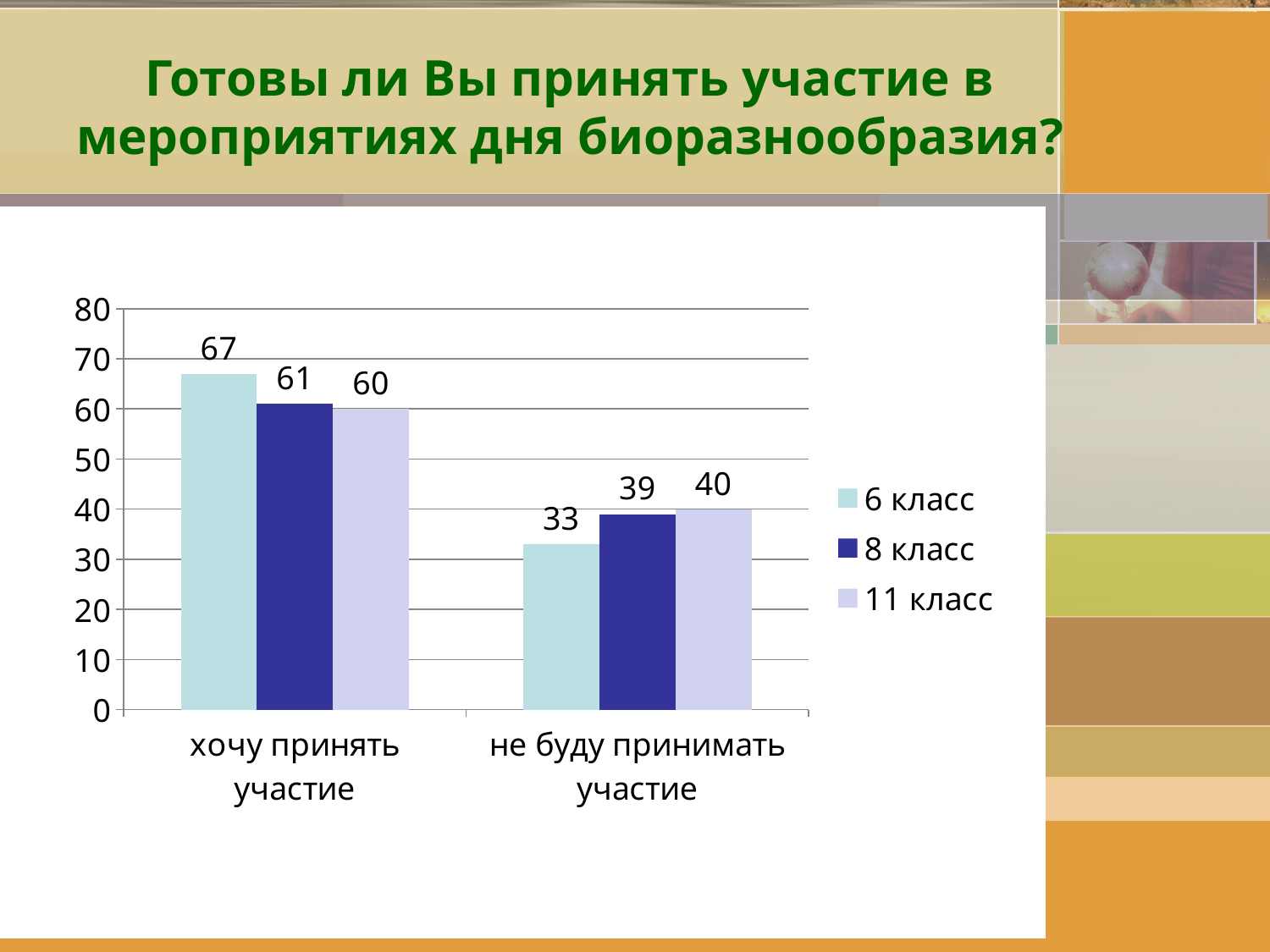
What is the title of the slide? Готовы ли Вы принять участие в мероприятиях дня биоразнообразия? What is the value for 6 класс in the category 'хочу принять участие'? 67 Which is larger: the 8 класс value for 'хочу принять участие' or the 11 класс value for 'хочу принять участие'? 8 класс Is the value for 6 класс in 'не буду принимать участие' greater or less than 40? less Which series has the highest value in the category 'хочу принять участие'? 6 класс Which series has the lowest value in the category 'не буду принимать участие'? 6 класс What is the value for 11 класс in the category 'не буду принимать участие'? 40 How many series does the legend list? 3 What kind of chart is shown on the slide? bar chart What is the value for 8 класс in the category 'хочу принять участие'? 61 How many categories are shown on the x axis? 2 What is the difference between the 6 класс values for 'хочу принять участие' and 'не буду принимать участие'? 34